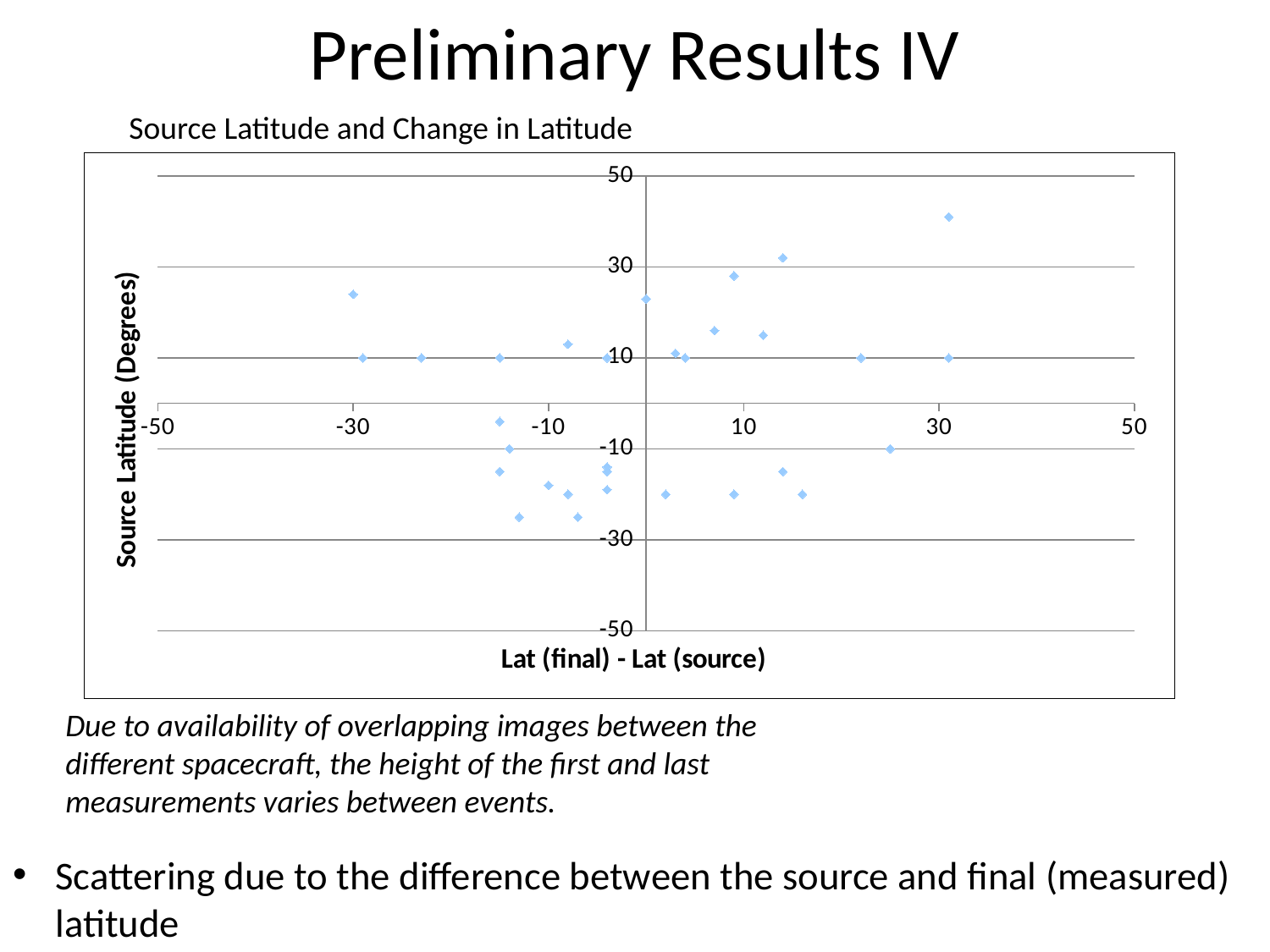
Is the lowest source latitude plotted on the chart greater or less than -30? greater Is the change in latitude (x value) of the leftmost point on the chart greater or less than -10? less What is the title of the chart? Source Latitude and Change in Latitude Is the highest source latitude plotted on the chart greater or less than 30? greater What is the label on the vertical axis of the chart? Source Latitude (Degrees) What kind of chart is shown on the slide? Scatter chart Is the source latitude of the point with the highest source latitude greater or less than the source latitude of the lowest point? greater